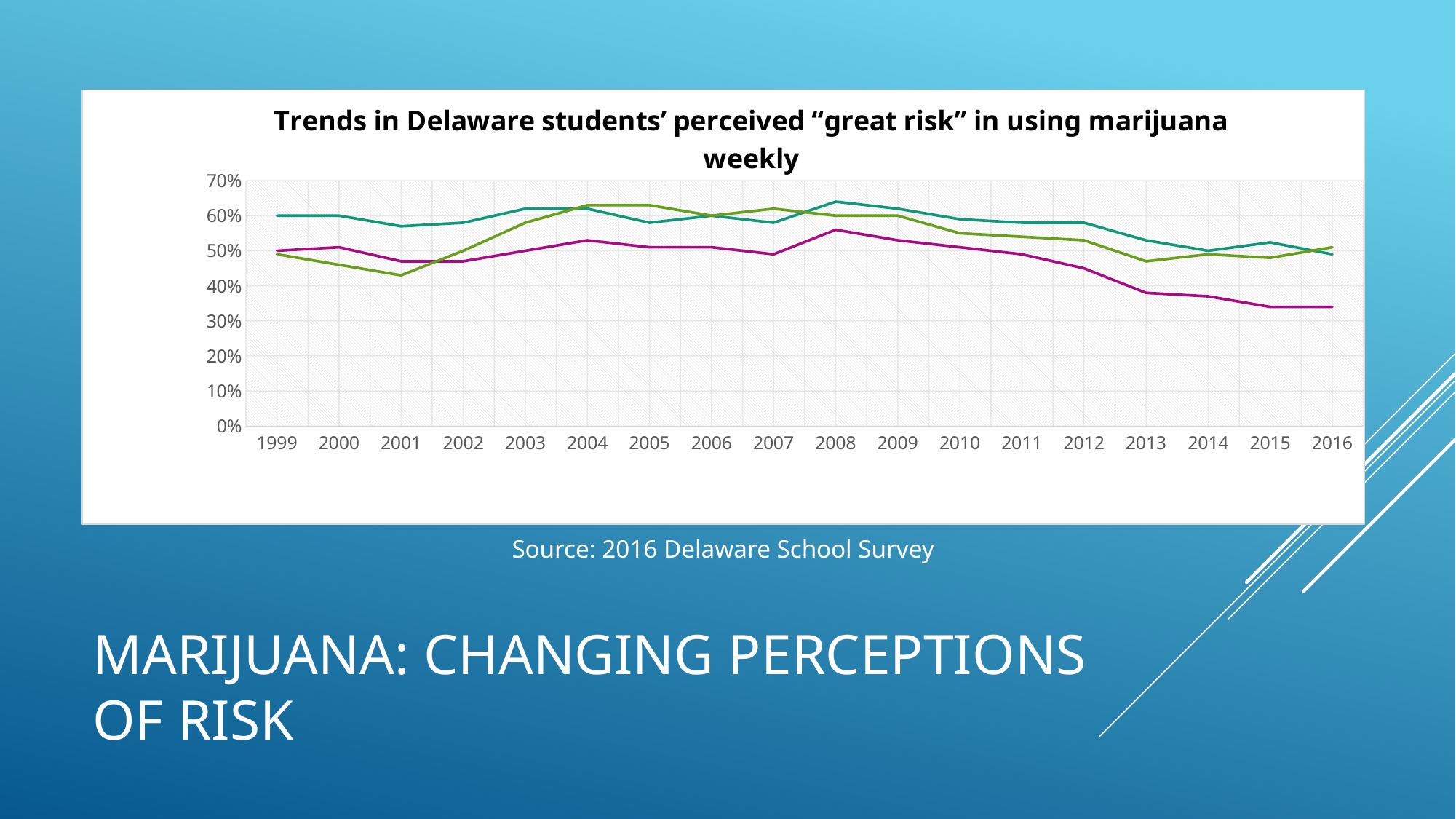
What is the first year shown on the x axis of the chart? 1999 Is the value of the green line in 2001 greater or less than 50%? less Is the value of the teal line in 1999 greater or less than 50%? greater How many lines are plotted on the chart? 3 What is the title of the chart? Trends in Delaware students' perceived "great risk" in using marijuana weekly In 2001, which line has the higher value, the green line or the magenta line? the magenta line What kind of chart is shown on the slide? line chart How many years are shown along the x axis of the chart? 18 Does the magenta line generally rise or fall from 2008 to 2016? fall In which year does the magenta line reach its highest value? 2008 Is the value of the magenta line in 2016 greater or less than 40%? less In 2016, which line has the higher value, the teal line or the magenta line? the teal line